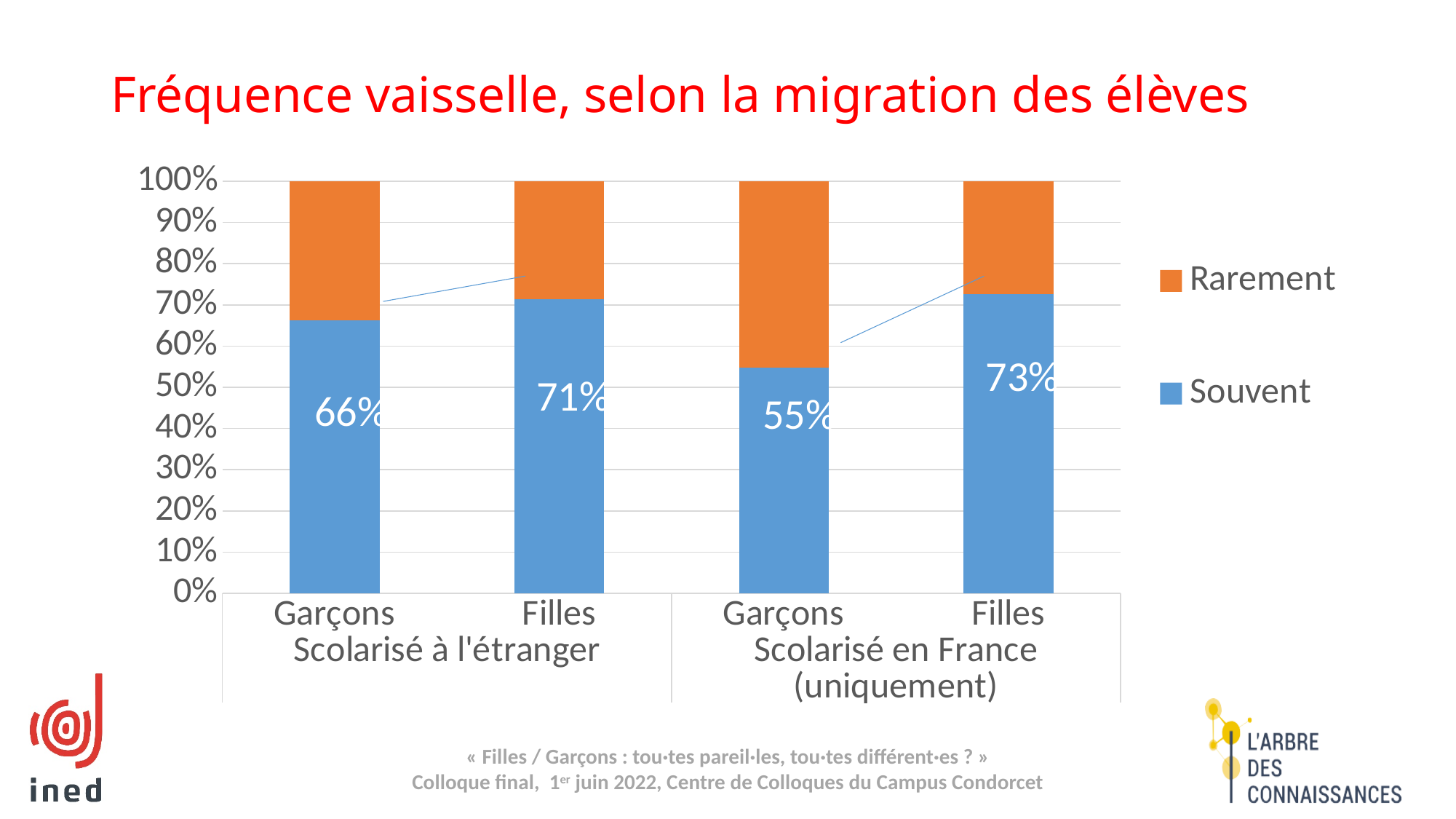
Which group has the lowest 'Souvent' share? Garçons, Scolarisé en France (uniquement) What is the 'Souvent' value for Garçons scolarisés en France (uniquement)? 55% How many bars are shown in the chart? 4 Is the 'Rarement' value for Garçons scolarisés en France (uniquement) greater or less than 40%? greater What is the 'Souvent' value for Filles scolarisées en France (uniquement)? 73% What kind of chart is shown on the slide? Stacked bar chart What is the difference between the 'Souvent' values for Filles and Garçons scolarisés en France (uniquement)? 18% Which has a larger 'Souvent' value: Garçons scolarisés à l'étranger or Garçons scolarisés en France (uniquement)? Garçons scolarisés à l'étranger What is the 'Souvent' value for Filles scolarisées à l'étranger? 71% Which group has the highest 'Souvent' share? Filles, Scolarisé en France (uniquement) How many series does the legend list? 2 What is the 'Souvent' value for Garçons scolarisés à l'étranger? 66%